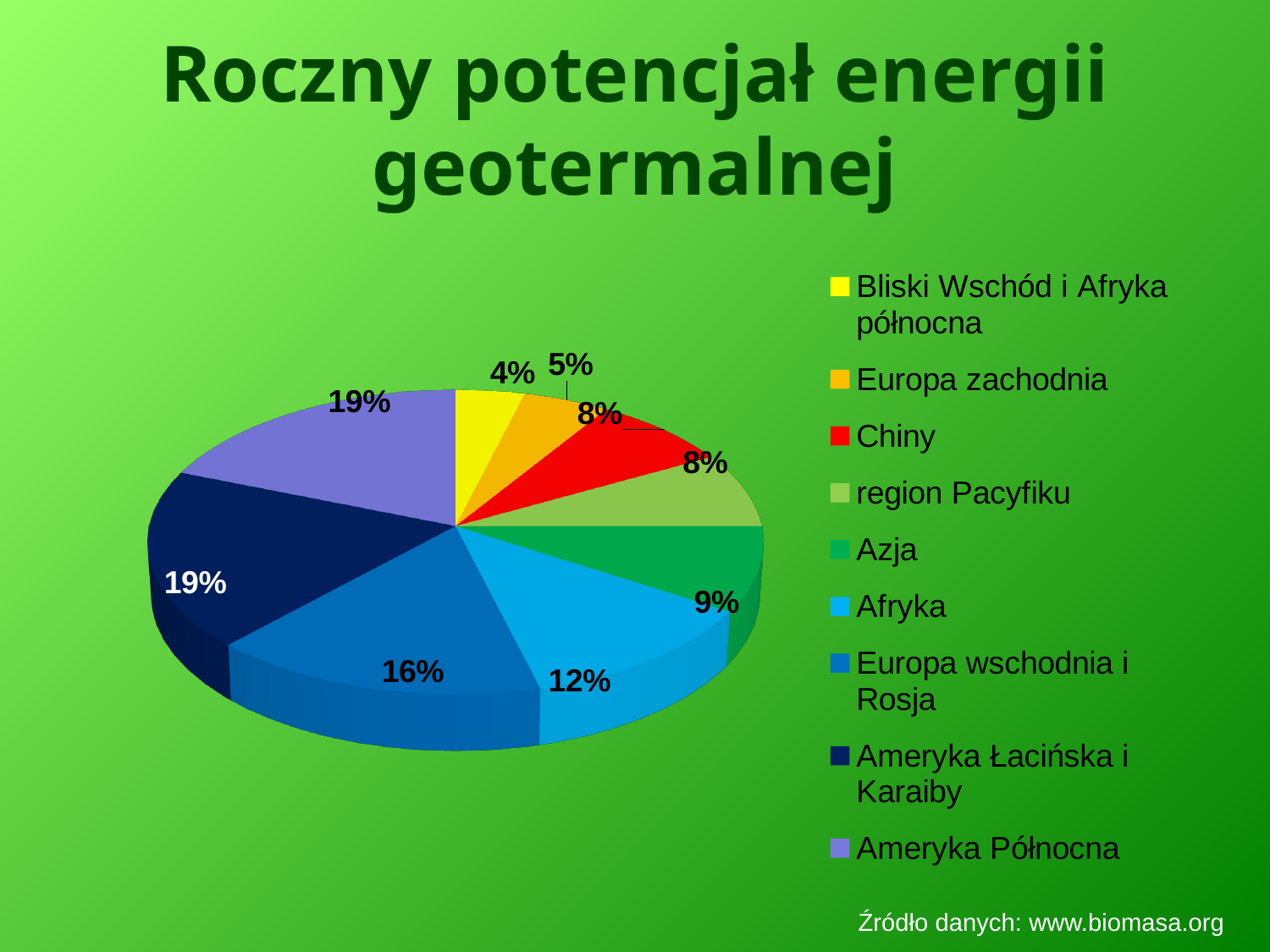
How many slices does the pie chart have? 9 What is the value shown for Chiny? 8% What is the difference between the shares of Ameryka Północna and Afryka? 7% What type of chart is shown on the slide? pie chart What share of the pie does Afryka represent? 12% Which is larger, the share for Azja or the share for Europa wschodnia i Rosja? Europa wschodnia i Rosja What is the value shown for Azja? 9% What colour is the slice for Ameryka Północna? purple What is the value shown for Europa wschodnia i Rosja? 16% Which region has the smallest share of the pie? Bliski Wschód i Afryka północna What is the title of the slide containing the chart? Roczny potencjał energii geotermalnej What is the value shown for Europa zachodnia? 5%